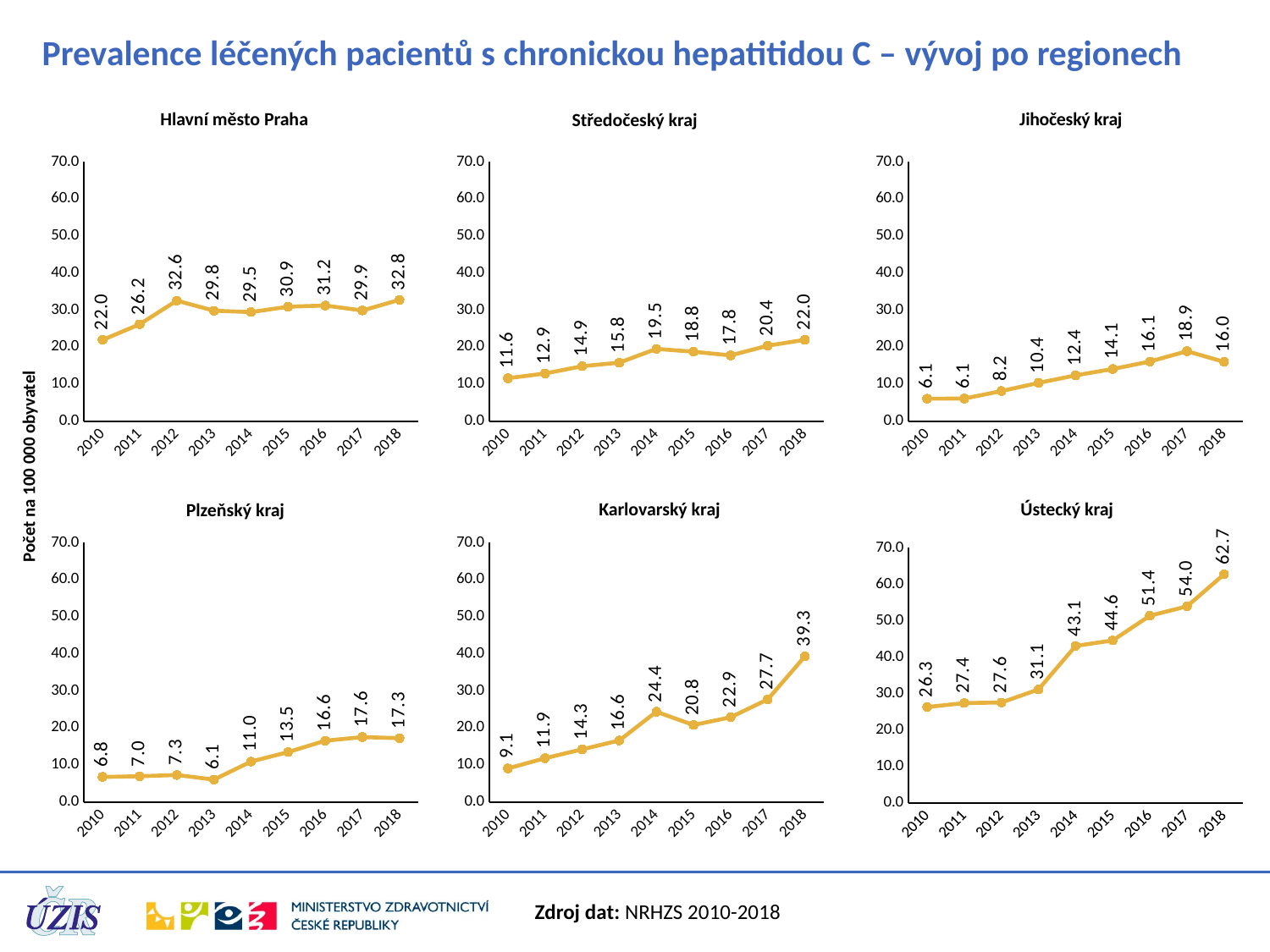
In the 'Jihočeský kraj' chart, which is larger, the value for 2017 or the value for 2018? 2017 In the 'Středočeský kraj' chart, what is the difference between the 2018 value and the 2010 value? 10.4 In the 'Karlovarský kraj' chart, which year has the highest value? 2018 In the 'Plzeňský kraj' chart, which year has the lowest value? 2013 What kind of chart is the 'Plzeňský kraj' chart? line chart What is the y-axis label shared by the charts on the slide? Počet na 100 000 obyvatel In the 'Hlavní město Praha' chart, what is the value for 2012? 32.6 In the 'Ústecký kraj' chart, is the value for 2016 greater or less than 50.0? greater How many charts are shown on the slide? 6 In the 'Ústecký kraj' chart, what is the value for 2018? 62.7 How many years are plotted in the 'Karlovarský kraj' chart? 9 In the 'Ústecký kraj' chart, do the values generally rise or fall from 2010 to 2018? rise